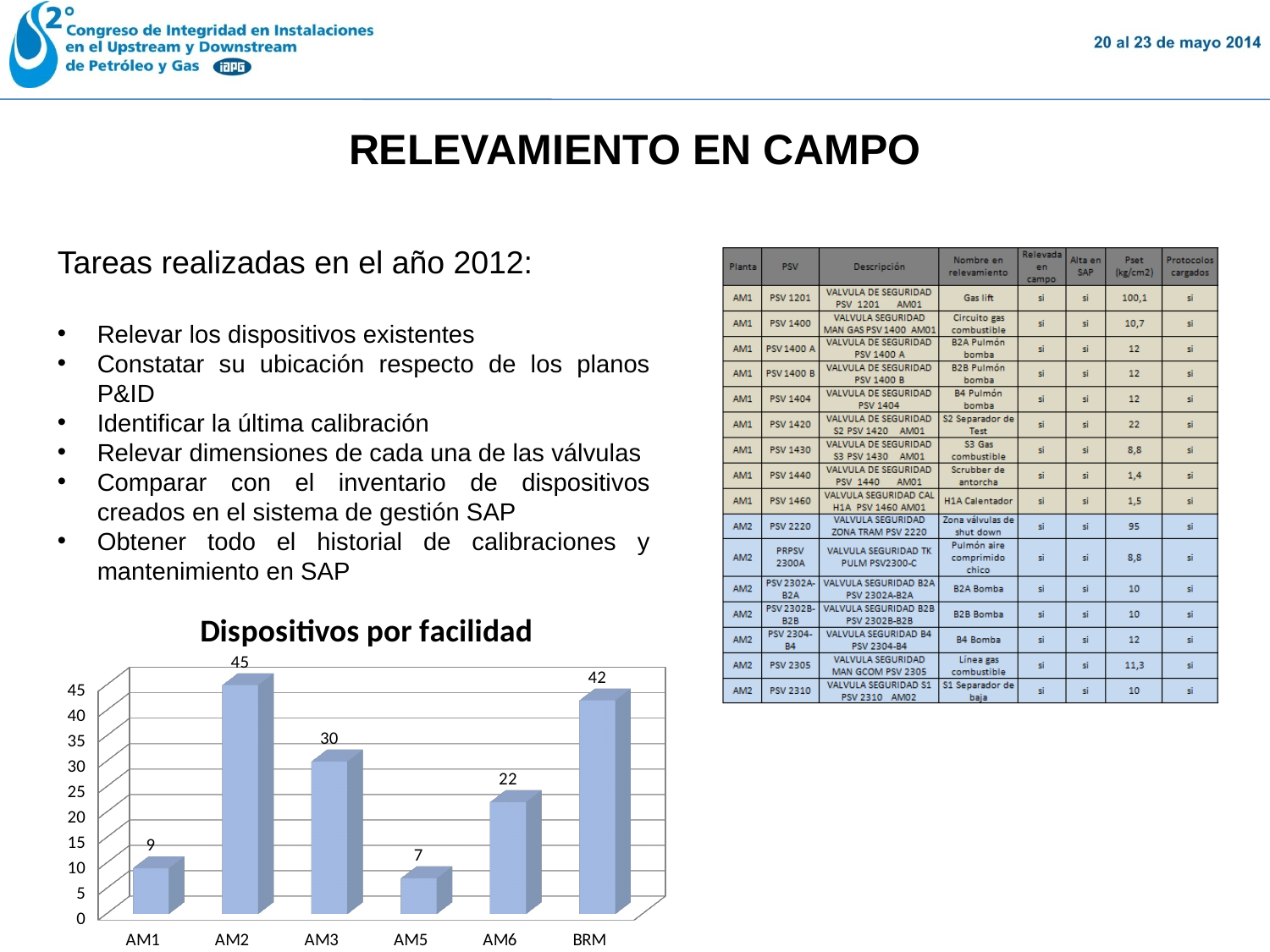
What is the value for AM2 in the 'Dispositivos por facilidad' chart? 45 Is the value for AM3 in the 'Dispositivos por facilidad' chart greater or less than 25? greater What is the value for AM6 in the 'Dispositivos por facilidad' chart? 22 Which category has the highest value in the 'Dispositivos por facilidad' chart? AM2 What kind of chart is 'Dispositivos por facilidad'? bar chart Which is larger in the 'Dispositivos por facilidad' chart, the value for AM1 or the value for AM5? AM1 What is the value for BRM in the 'Dispositivos por facilidad' chart? 42 How many categories are shown in the 'Dispositivos por facilidad' chart? 6 What is the title of the chart on the slide? Dispositivos por facilidad What is the difference between the values for AM2 and AM3 in the 'Dispositivos por facilidad' chart? 15 Which category has the lowest value in the 'Dispositivos por facilidad' chart? AM5 What is the difference between the values for BRM and AM6 in the 'Dispositivos por facilidad' chart? 20